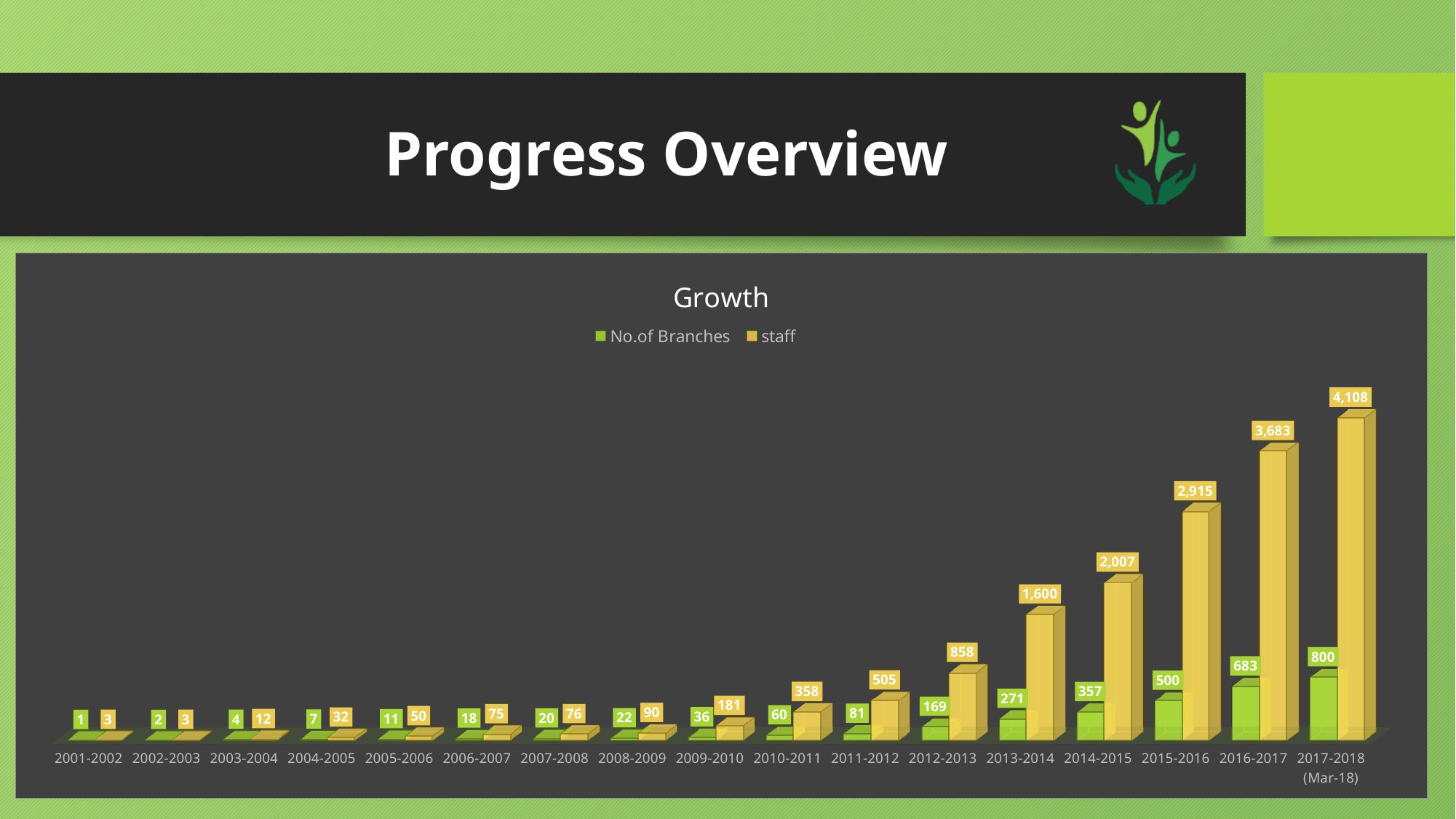
How many series does the legend list? 2 Which period has the highest staff value? 2017-2018 (Mar-18) What is the difference between the staff values for 2017-2018 (Mar-18) and 2016-2017? 425 What is the staff value for 2015-2016? 2,915 What kind of chart is shown on the slide? Bar chart Do the staff values rise or fall from 2001-2002 to 2017-2018 (Mar-18)? Rise Which period has the lowest No.of Branches value? 2001-2002 How many periods are shown on the x axis? 17 Which is larger, the staff value for 2012-2013 or the staff value for 2011-2012? 2012-2013 What is the No.of Branches value for 2013-2014? 271 What is the difference between the No.of Branches values for 2016-2017 and 2015-2016? 183 What is the staff value for 2009-2010? 181